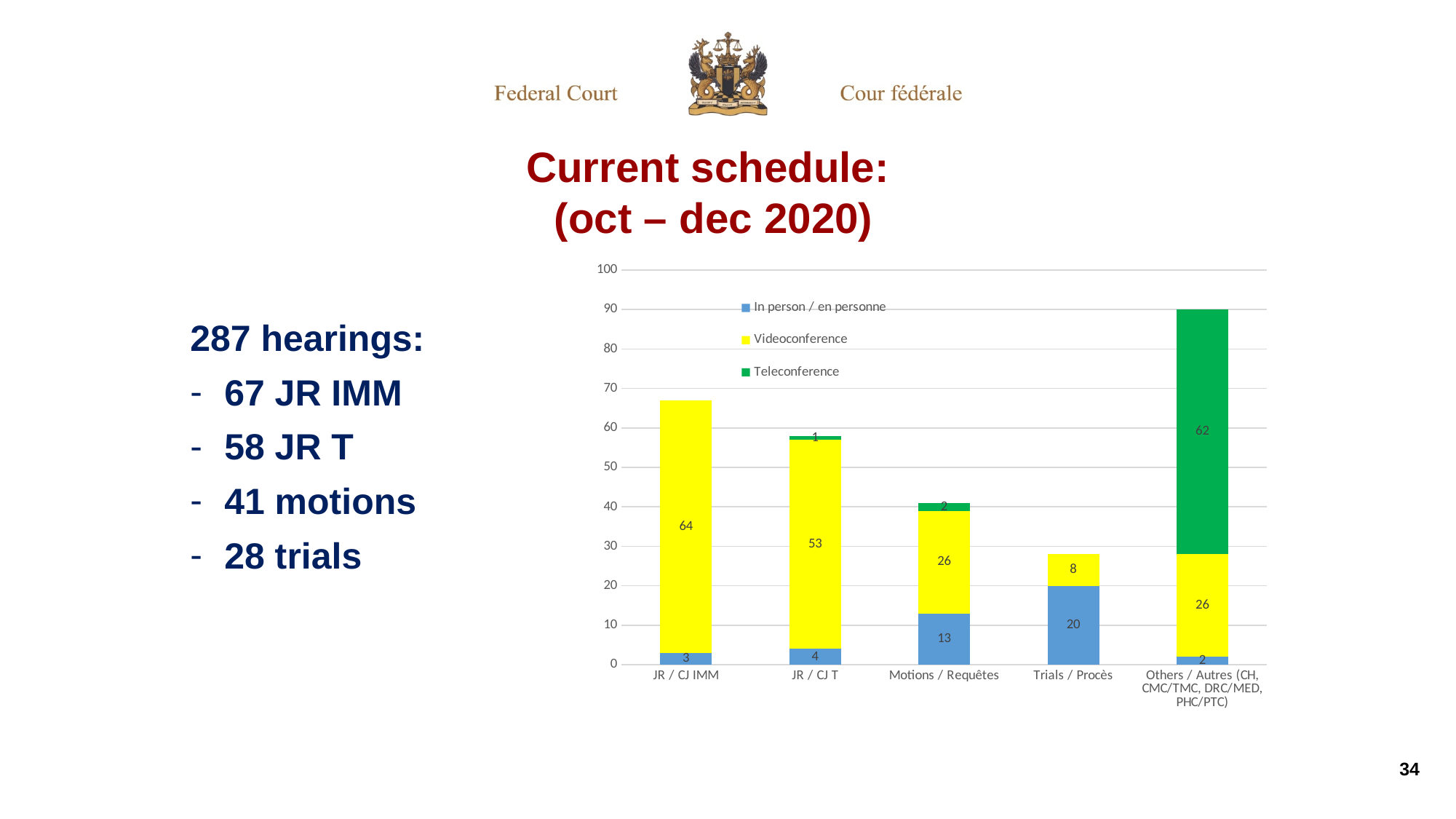
Which category has the lowest Videoconference value? Trials / Procès How many series does the legend list? 3 How many categories are shown on the x axis? 5 What kind of chart is shown on the slide? Stacked bar chart Which is larger: the In person / en personne value for Motions / Requêtes or for Trials / Procès? Trials / Procès What is the In person / en personne value for Motions / Requêtes? 13 Which category has the highest In person / en personne value? Trials / Procès What is the Teleconference value for Others / Autres (CH, CMC/TMC, DRC/MED, PHC/PTC)? 62 What is the Videoconference value for JR / CJ IMM? 64 What is the In person / en personne value for Trials / Procès? 20 What is the total of the stacked bar for Motions / Requêtes? 41 What is the difference between the Videoconference values for JR / CJ IMM and JR / CJ T? 11